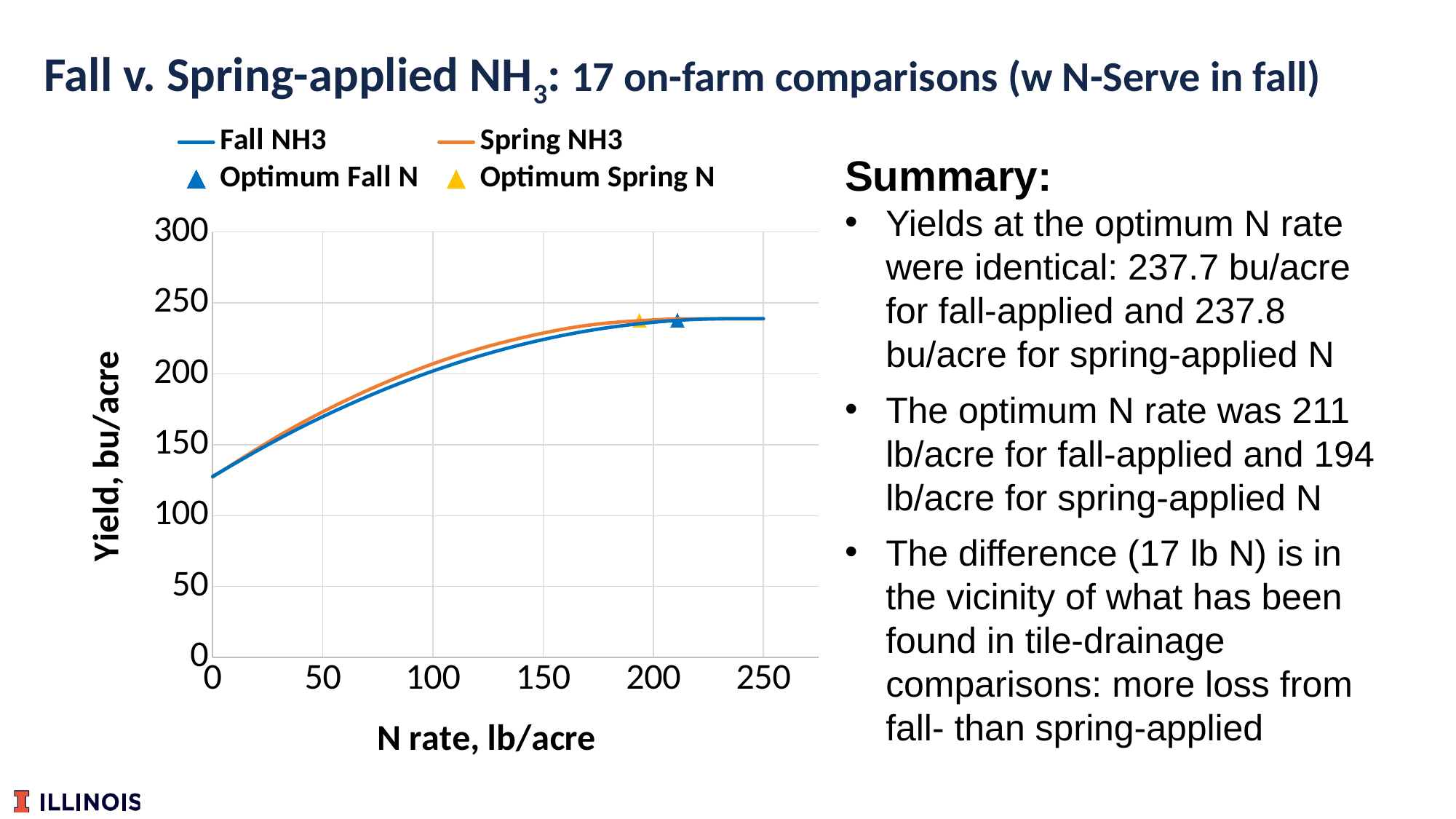
How many entries does the chart legend list? 4 Is the Fall NH3 yield at an N rate of 250 greater or less than 250 bu/acre? less What kind of chart is shown on the slide? line chart What is the title of the chart's x axis? N rate, lb/acre Do the yield curves rise or fall as the N rate increases from 0 to 250 lb/acre? rise Is the Spring NH3 yield at an N rate of 150 greater or less than 200 bu/acre? greater Which optimum N marker sits at a higher N rate, Optimum Fall N or Optimum Spring N? Optimum Fall N According to the slide, what was the optimum N rate for fall-applied N? 211 lb/acre What is the title of the chart's y axis? Yield, bu/acre What is the difference between the fall-applied and spring-applied optimum N rates stated on the slide? 17 lb N Is the Fall NH3 yield at an N rate of 0 greater or less than 150 bu/acre? less According to the slide, what was the optimum N rate for spring-applied N? 194 lb/acre